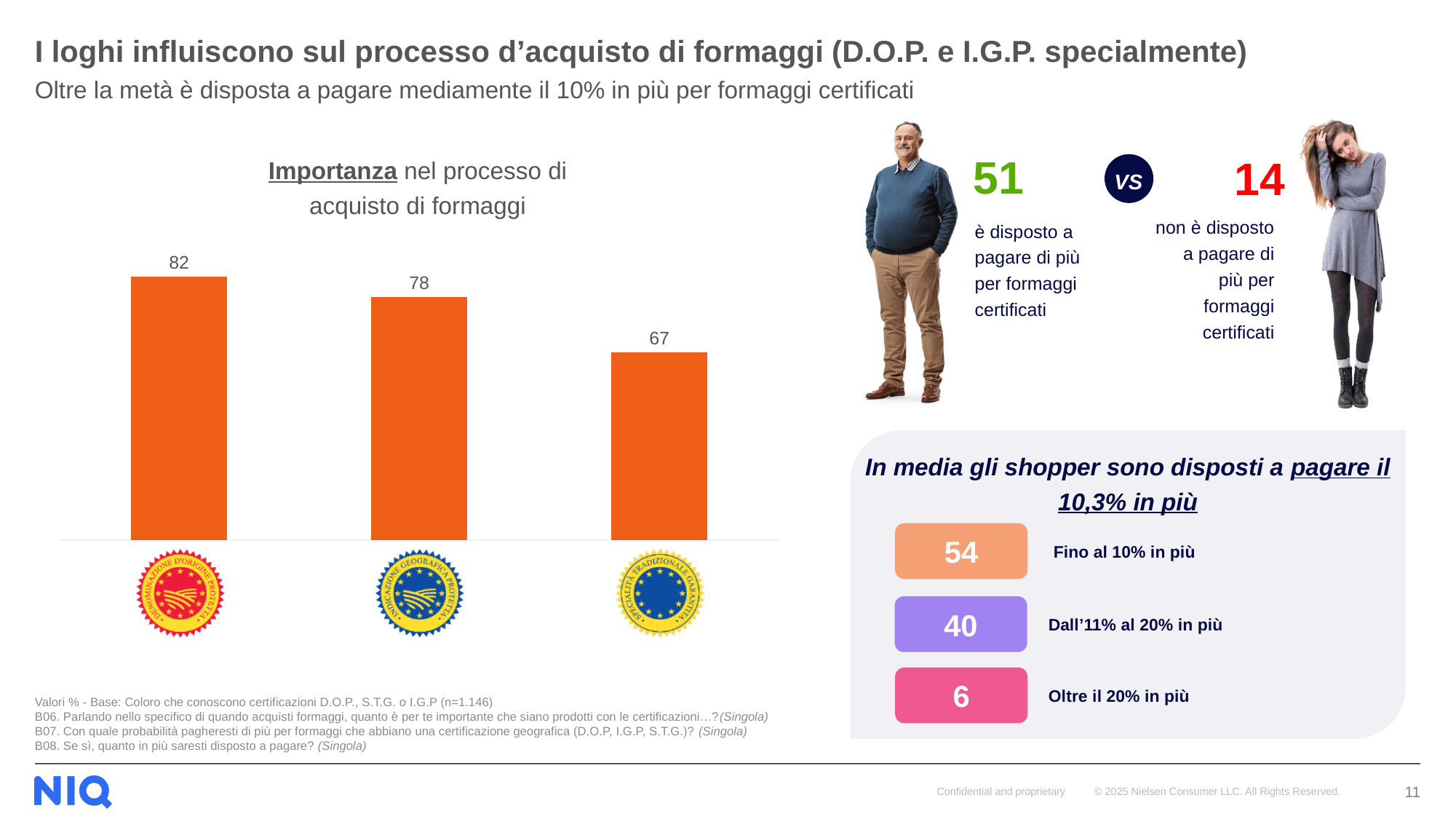
What type of chart is shown under the title "Importanza nel processo di acquisto di formaggi"? bar chart In the "Importanza nel processo di acquisto di formaggi" chart, what is the value of the first (leftmost) bar, above the red D.O.P. logo? 82 In the "Importanza nel processo di acquisto di formaggi" chart, which bar has the lowest value? the third bar (S.T.G. logo), 67 In the "Importanza nel processo di acquisto di formaggi" chart, which bar has the highest value? the first bar (D.O.P. logo), 82 In the "Importanza nel processo di acquisto di formaggi" chart, what is the difference between the first bar and the middle bar? 4 How many bars are in the "Importanza nel processo di acquisto di formaggi" chart? 3 In the "Importanza nel processo di acquisto di formaggi" chart, what is the value of the middle bar, above the blue I.G.P. logo? 78 What colour are the bars in the "Importanza nel processo di acquisto di formaggi" chart? orange In the "Importanza nel processo di acquisto di formaggi" chart, is the middle bar (I.G.P.) larger or smaller than the rightmost bar (S.T.G.)? larger In the "Importanza nel processo di acquisto di formaggi" chart, what is the difference between the first bar (82) and the third bar (67)? 15 In the "Importanza nel processo di acquisto di formaggi" chart, what is the value of the third (rightmost) bar, above the S.T.G. logo? 67 Do the values in the "Importanza nel processo di acquisto di formaggi" chart rise or fall from left to right? fall